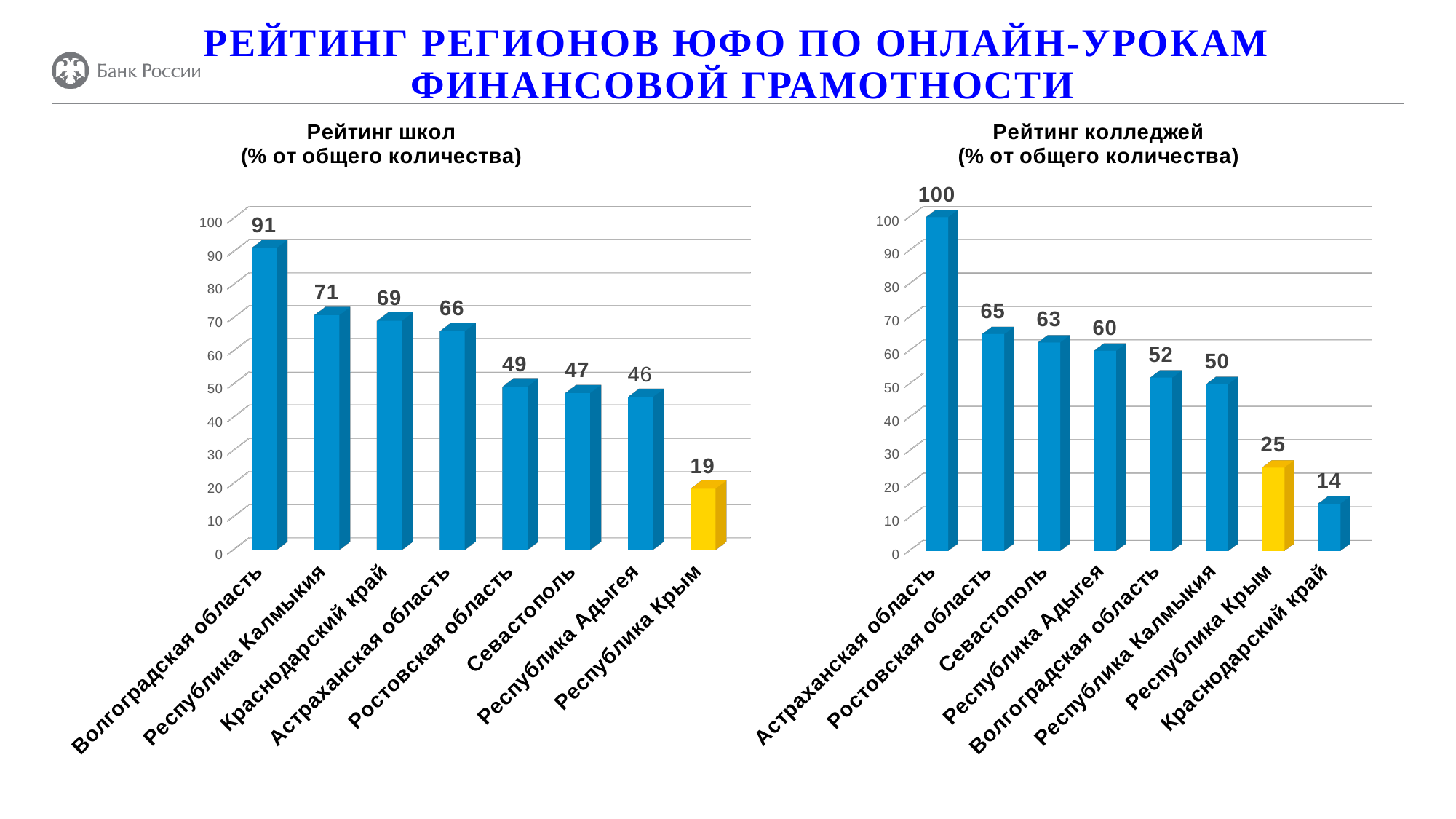
In the 'Рейтинг колледжей' chart, what is the difference between Республика Крым and Краснодарский край? 11 In the 'Рейтинг школ' chart, which region has the lowest value? Республика Крым In the 'Рейтинг колледжей' chart, what is the value for Севастополь? 63 In the 'Рейтинг школ' chart, what is the value for Волгоградская область? 91 In the 'Рейтинг школ' chart, do the values rise or fall from left to right? Fall In the 'Рейтинг колледжей' chart, which region has the lowest value? Краснодарский край In the 'Рейтинг школ' chart, what is the value for Республика Крым? 19 What type of chart is the 'Рейтинг школ' chart? Bar chart In the 'Рейтинг колледжей' chart, which region has the highest value? Астраханская область In the 'Рейтинг школ' chart, which is larger: Ростовская область or Севастополь? Ростовская область How many regions are shown in the 'Рейтинг колледжей' chart? 8 In the 'Рейтинг школ' chart, what is the difference between Волгоградская область and Республика Калмыкия? 20